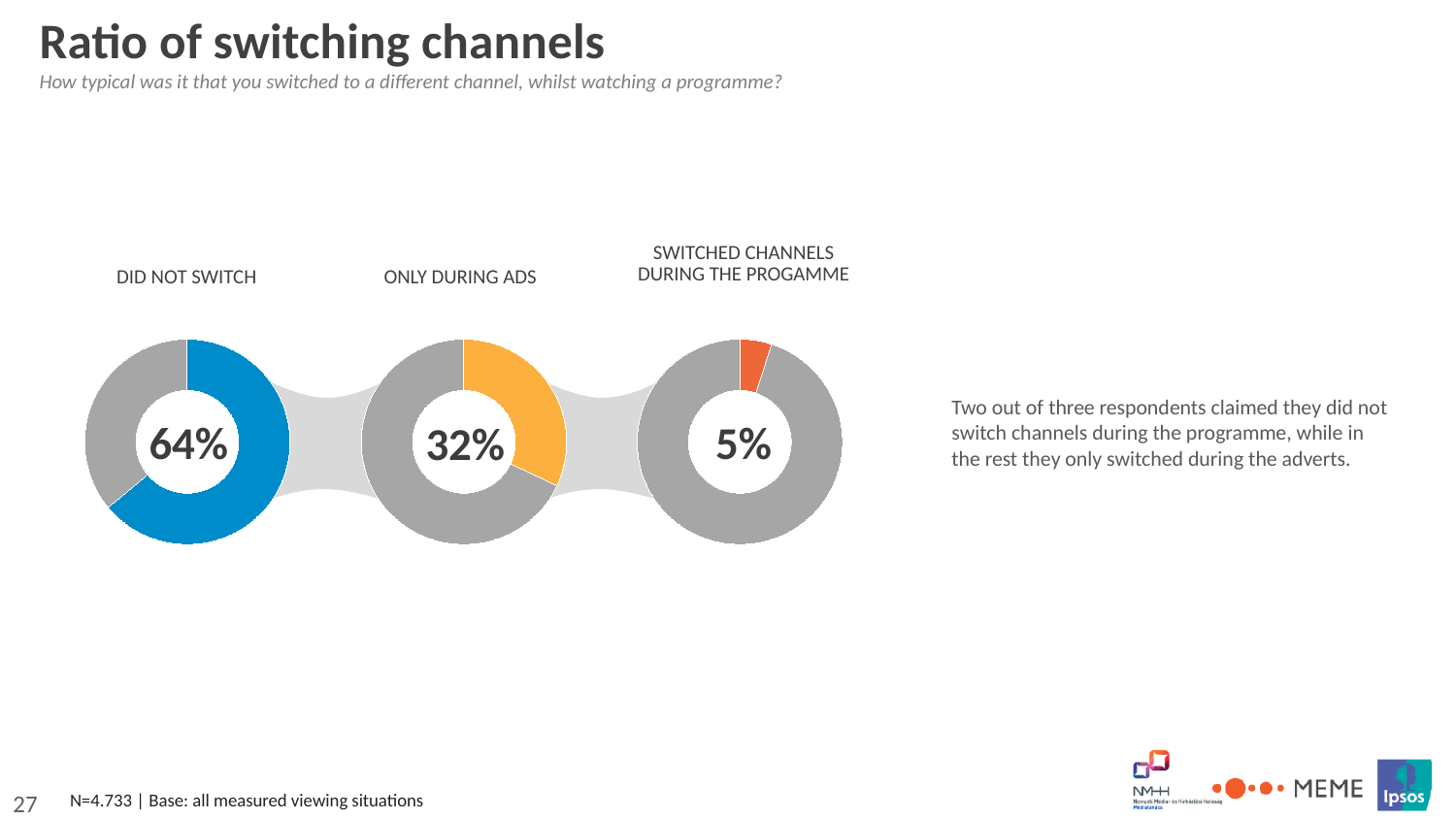
What is the difference between the 'DID NOT SWITCH' percentage and the 'ONLY DURING ADS' percentage? 32% Which is larger: the 'ONLY DURING ADS' percentage or the 'SWITCHED CHANNELS DURING THE PROGAMME' percentage? ONLY DURING ADS What percentage is shown in the 'DID NOT SWITCH' donut chart? 64% Across the three donut charts, which category has the highest percentage? DID NOT SWITCH How many donut charts are shown on the slide? 3 What percentage is shown in the 'SWITCHED CHANNELS DURING THE PROGAMME' donut chart? 5% What colour is the highlighted segment in the 'ONLY DURING ADS' donut chart? Orange/yellow What is the difference between the 'ONLY DURING ADS' percentage and the 'SWITCHED CHANNELS DURING THE PROGAMME' percentage? 27% What type of chart is used to show the 'DID NOT SWITCH' value? Donut chart What is the title of the slide containing the three donut charts? Ratio of switching channels Across the three donut charts, which category has the lowest percentage? SWITCHED CHANNELS DURING THE PROGAMME What percentage is shown in the 'ONLY DURING ADS' donut chart? 32%